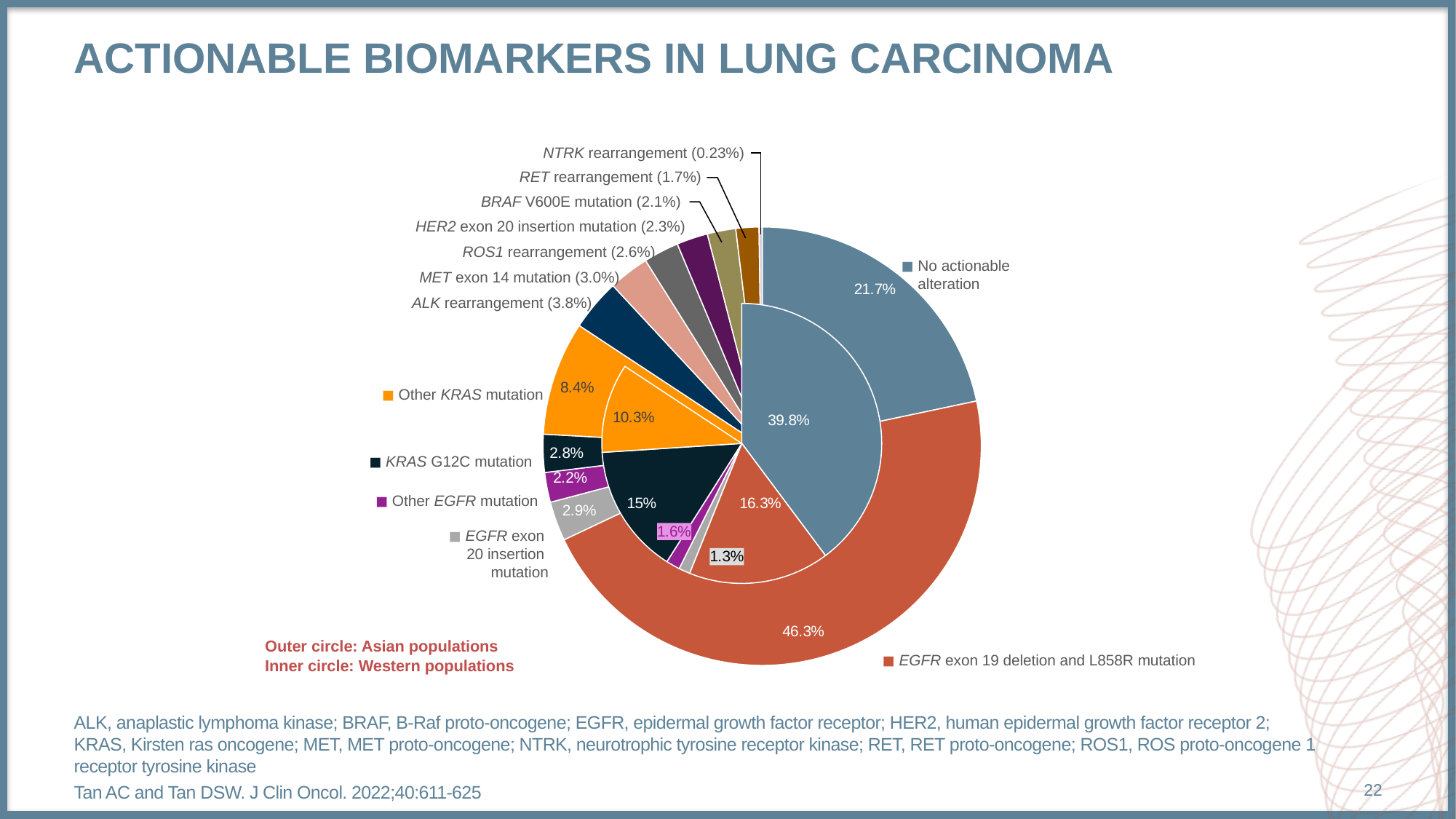
In the inner circle (Western populations), what percentage is labelled for KRAS G12C mutation? 15% In the inner circle (Western populations), what percentage is shown for EGFR exon 19 deletion and L858R mutation? 16.3% Which category has the largest slice in the outer circle (Asian populations)? EGFR exon 19 deletion and L858R mutation In the inner circle (Western populations), what percentage is labelled for No actionable alteration? 39.8% What is the difference between the No actionable alteration share in the inner circle (39.8%) and in the outer circle (21.7%)? 18.1% Which labelled category has the smallest share in the outer circle? NTRK rearrangement What kind of chart is shown on the slide? Pie chart What percentage is given for NTRK rearrangement? 0.23% In the outer circle (Asian populations), what percentage is labelled for No actionable alteration? 21.7% Is the share for Other KRAS mutation larger in the outer circle (Asian) or the inner circle (Western)? Inner circle (Western), 10.3% What percentage is given for ALK rearrangement in the outer circle? 3.8% In the outer circle (Asian populations), what percentage is shown for EGFR exon 19 deletion and L858R mutation? 46.3%